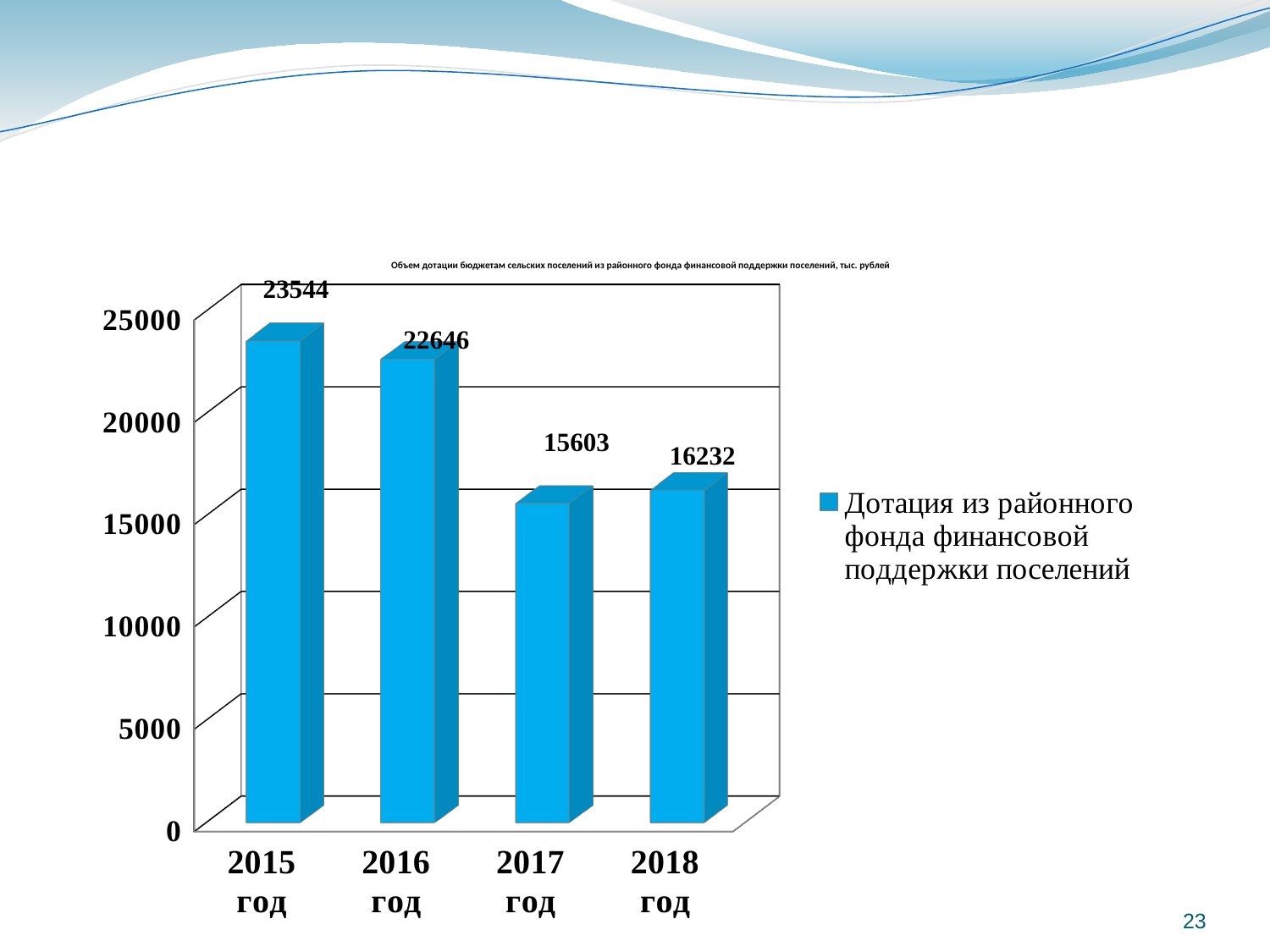
Which year has the lowest value? 2017 год Which is larger, the value for 2016 год or the value for 2018 год? 2016 год What is the difference between the values for 2018 год and 2017 год? 629 What kind of chart is shown on the slide? bar chart How many years are shown on the x axis? 4 What is the value for 2017 год? 15603 What is the legend entry for the series? Дотация из районного фонда финансовой поддержки поселений What is the value for 2018 год? 16232 Which year has the highest value? 2015 год Is the value for 2017 год greater or less than 20000? less What is the value for 2015 год? 23544 What is the difference between the values for 2015 год and 2016 год? 898